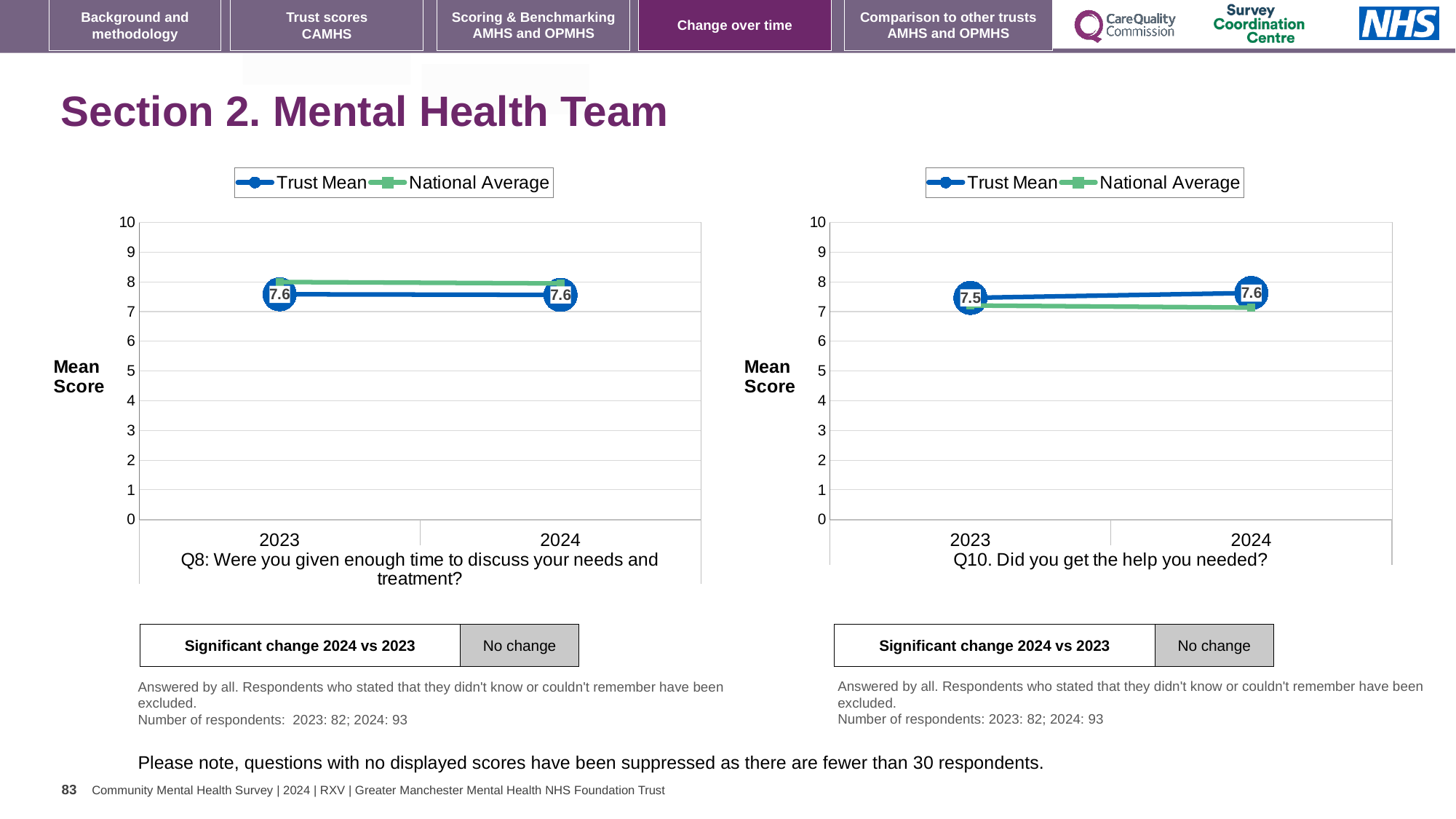
In the Q8 chart on the left, what is the Trust Mean for 2024? 7.6 In the Q8 chart on the left, which is higher in 2024, the Trust Mean or the National Average? National Average In the Q10 chart on the right, does the Trust Mean rise or fall from 2023 to 2024? Rise How many series does the legend of the Q10 chart on the right list? 2 In the Q8 chart on the left, what is the Trust Mean for 2023? 7.6 In the Q10 chart on the right, what is the difference between the Trust Mean for 2024 and 2023? 0.1 In the Q10 chart on the right, which is higher in 2023, the Trust Mean or the National Average? Trust Mean In the Q8 chart on the left, is the National Average for 2023 greater or less than 7? greater How many years are plotted on the x axis of the Q8 chart on the left? 2 What type of chart is used for Q8 on the left? Line chart In the Q10 chart on the right, what is the Trust Mean for 2023? 7.5 In the Q10 chart on the right, what is the Trust Mean for 2024? 7.6